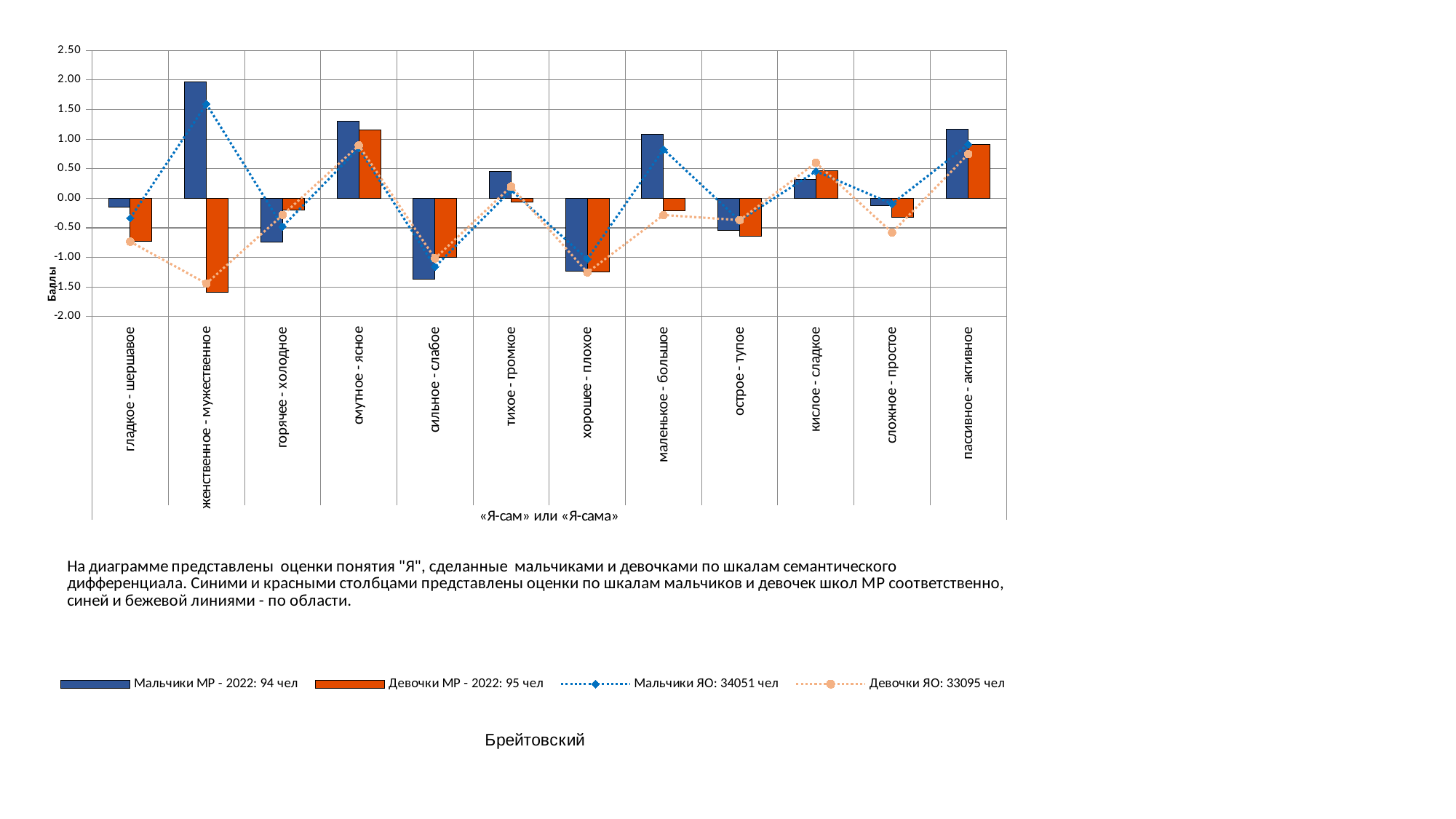
At 'маленькое - большое', which is larger: the value for 'Мальчики МР - 2022: 94 чел' or for 'Девочки МР - 2022: 95 чел'? Мальчики МР - 2022: 94 чел Is the value for 'Девочки ЯО: 33095 чел' at 'гладкое - шершавое' greater or less than -0.50? less What kind of chart is shown on the slide? A combined bar and line chart For which category is the value of the series 'Девочки МР - 2022: 95 чел' the lowest? женственное - мужественное How many categories are shown along the x axis of the chart? 12 What is the title of the horizontal axis of the chart? «Я-сам» или «Я-сама» For which category is the value of the series 'Девочки МР - 2022: 95 чел' the highest? смутное - ясное Is the value for 'Девочки МР - 2022: 95 чел' at 'женственное - мужественное' greater or less than -1.00? less For which category is the value of the series 'Мальчики МР - 2022: 94 чел' the highest? женственное - мужественное How many series does the chart legend list? 4 What is the title of the vertical axis of the chart? Баллы Is the value for 'Мальчики МР - 2022: 94 чел' at 'женственное - мужественное' greater or less than 1.50? greater